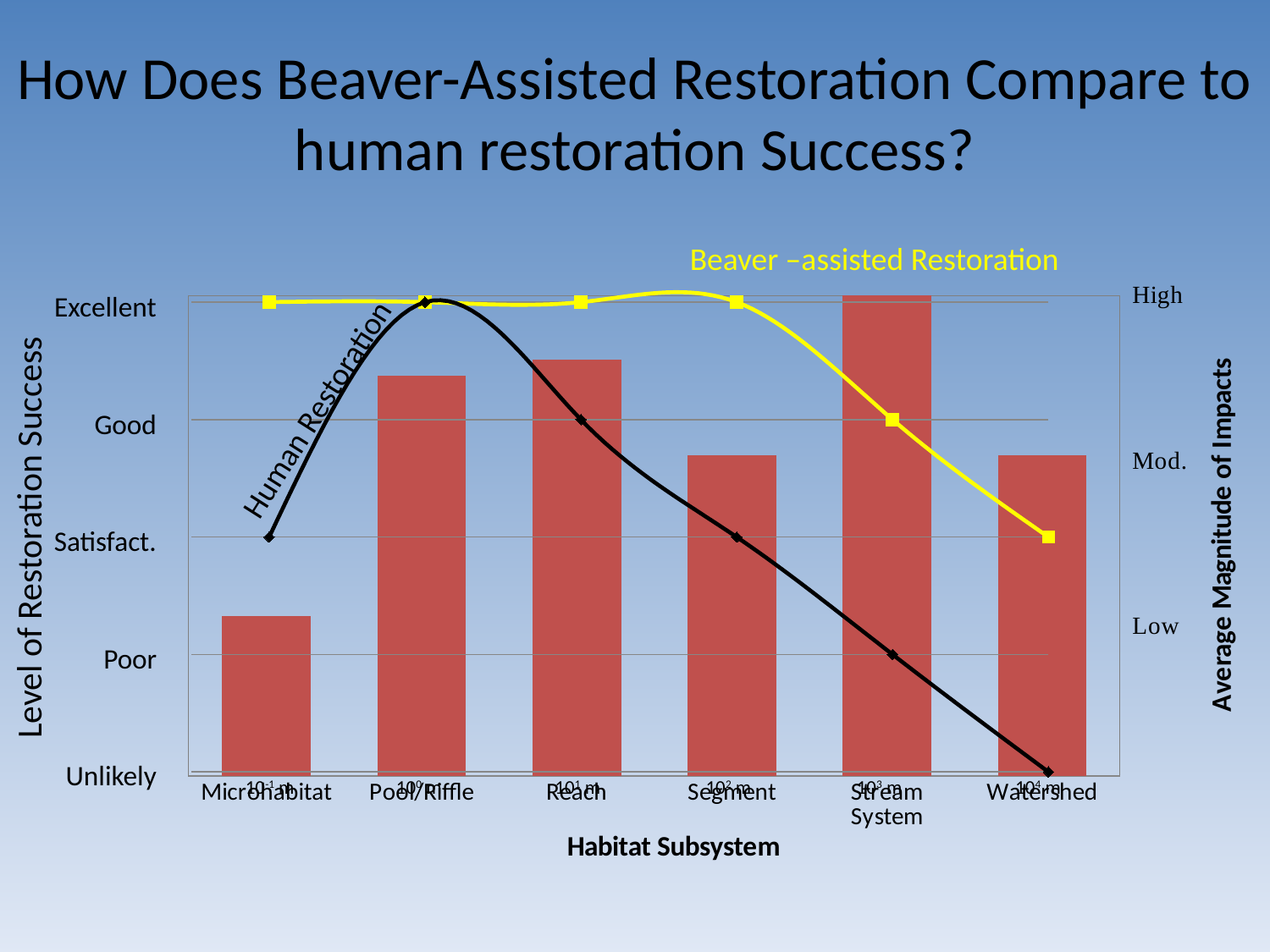
What level of restoration success does the Beaver-assisted Restoration line show for Stream System? Good Does the Human Restoration line rise or fall from Pool/Riffle to Watershed? fall What is the title of the x axis? Habitat Subsystem Which habitat subsystem has the tallest bar for Average Magnitude of Impacts? Stream System What level of restoration success does the Human Restoration line show for Watershed? Unlikely Which has a taller Average Magnitude of Impacts bar, Reach or Segment? Reach What level of restoration success does the Human Restoration line show for Stream System? Poor Is the Average Magnitude of Impacts bar for Pool/Riffle greater or less than Mod.? greater Which habitat subsystem has the shortest bar for Average Magnitude of Impacts? Microhabitat What level of restoration success does the Human Restoration line show for Microhabitat? Satisfact. What level of restoration success does the Beaver-assisted Restoration line show for Watershed? Satisfact. How many habitat subsystems are shown on the x axis? 6